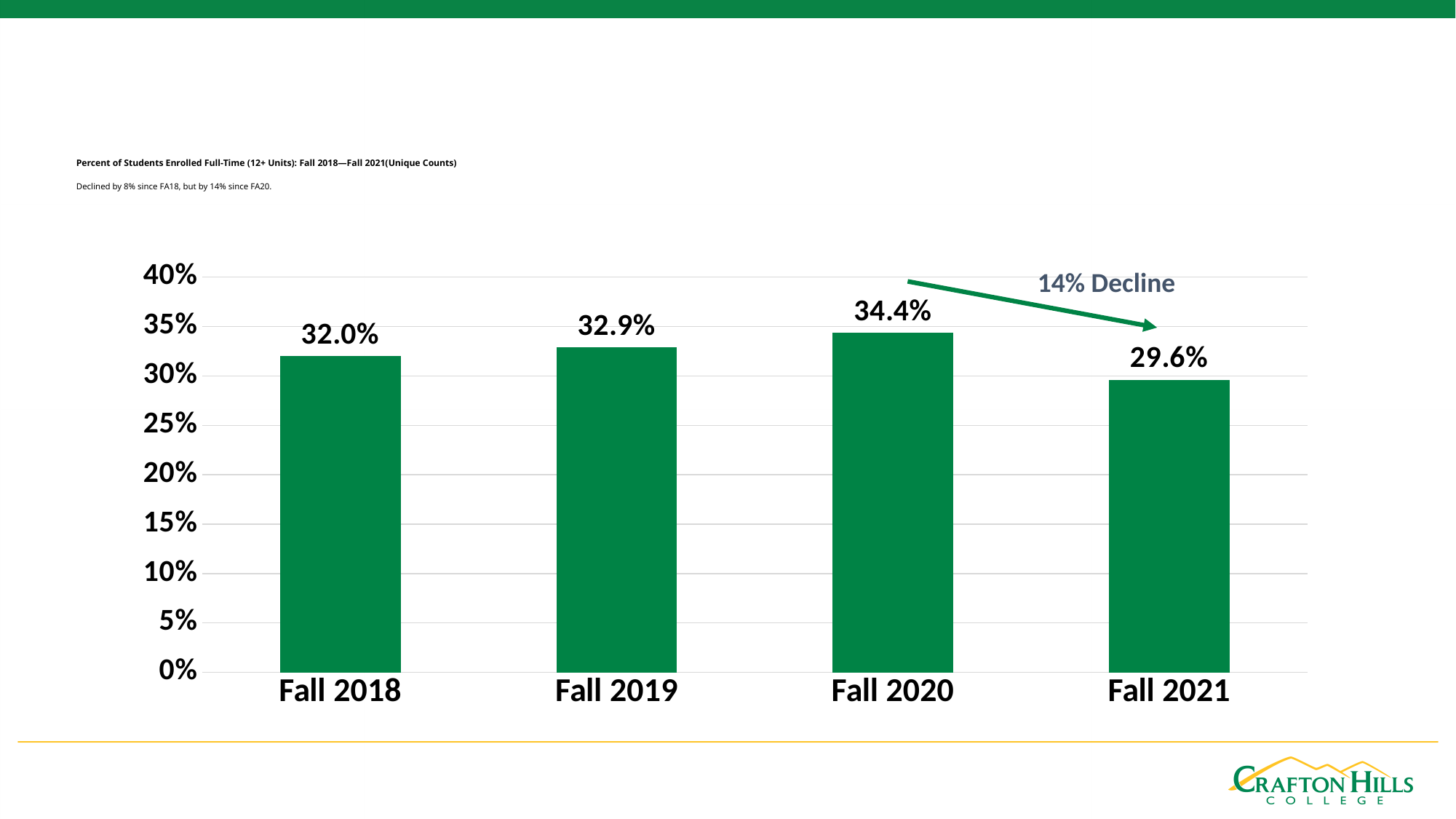
What is the value for Fall 2020? 34.4% What is the difference between the Fall 2020 and Fall 2021 values? 4.8% What is the value for Fall 2021? 29.6% What is the value for Fall 2018? 32.0% Which is larger, the value for Fall 2019 or the value for Fall 2021? Fall 2019 Which term has the lowest percent of students enrolled full-time? Fall 2021 Is the value for Fall 2021 greater or less than 30%? less What is the difference between the Fall 2019 and Fall 2018 values? 0.9% Which term has the highest percent of students enrolled full-time? Fall 2020 What kind of chart is shown on the slide? bar chart How many terms are shown on the x axis? 4 What does the annotation next to the arrow between Fall 2020 and Fall 2021 say? 14% Decline